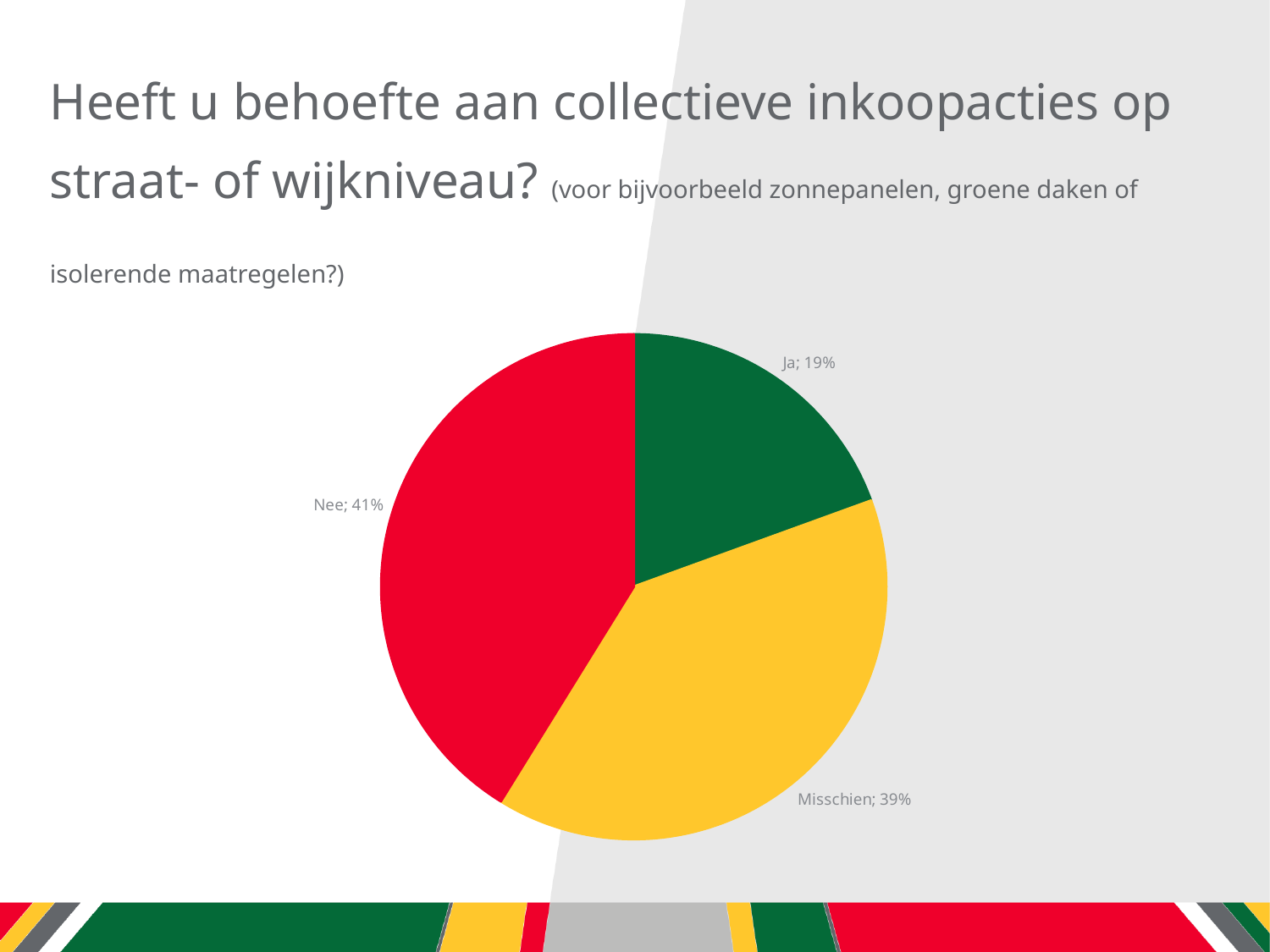
What is the difference in percentage points between "Nee" and "Ja"? 22 How many slices does the pie chart have? 3 What colour is the "Nee" slice? Red What percentage of respondents answered "Misschien"? 39% What kind of chart is shown on the slide? Pie chart What is the difference in percentage points between "Misschien" and "Ja"? 20 What percentage of respondents answered "Ja"? 19% Which answer has the smallest share of the pie? Ja Which answer has the largest share of the pie? Nee What colour is the "Ja" slice? Green What percentage of respondents answered "Nee"? 41% Which is larger, the share for "Ja" or the share for "Misschien"? Misschien